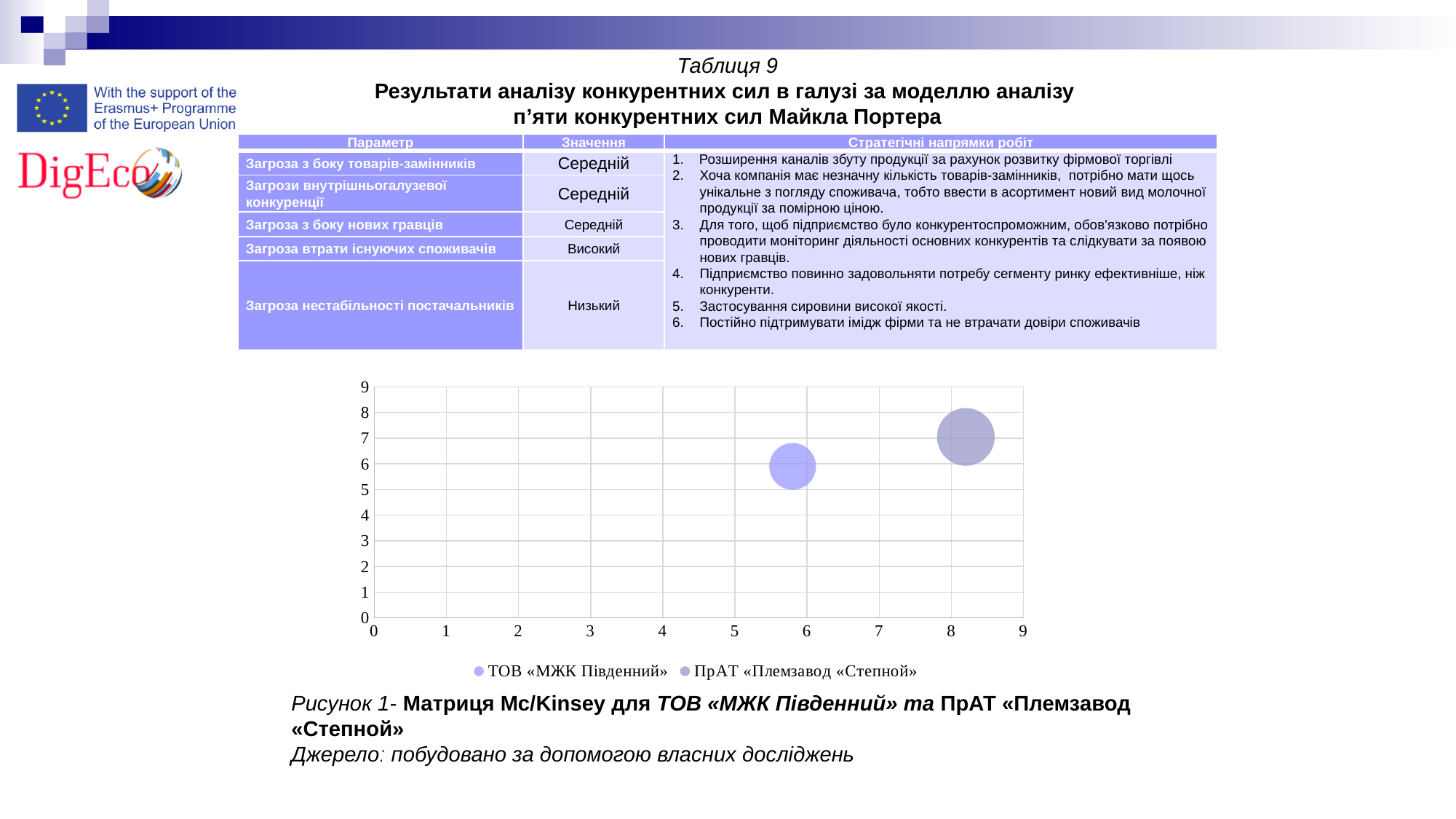
Which series is plotted higher on the vertical axis, ТОВ «МЖК Південний» or ПрАТ «Племзавод «Степной»? ПрАТ «Племзавод «Степной» Is the vertical-axis value for ПрАТ «Племзавод «Степной» greater or less than 6? greater Is the vertical-axis value for ТОВ «МЖК Південний» greater or less than 5? greater What is the first series listed in the chart legend? ТОВ «МЖК Південний» What is the maximum value shown on the vertical axis of the chart? 9 Which series has the larger bubble? ПрАТ «Племзавод «Степной» Which series is plotted further to the right on the horizontal axis? ПрАТ «Племзавод «Степной» What kind of chart is shown on the slide? bubble chart How many bubbles are plotted on the chart? 2 How many series does the chart legend list? 2 Is the horizontal-axis value for ПрАТ «Племзавод «Степной» greater or less than 7? greater